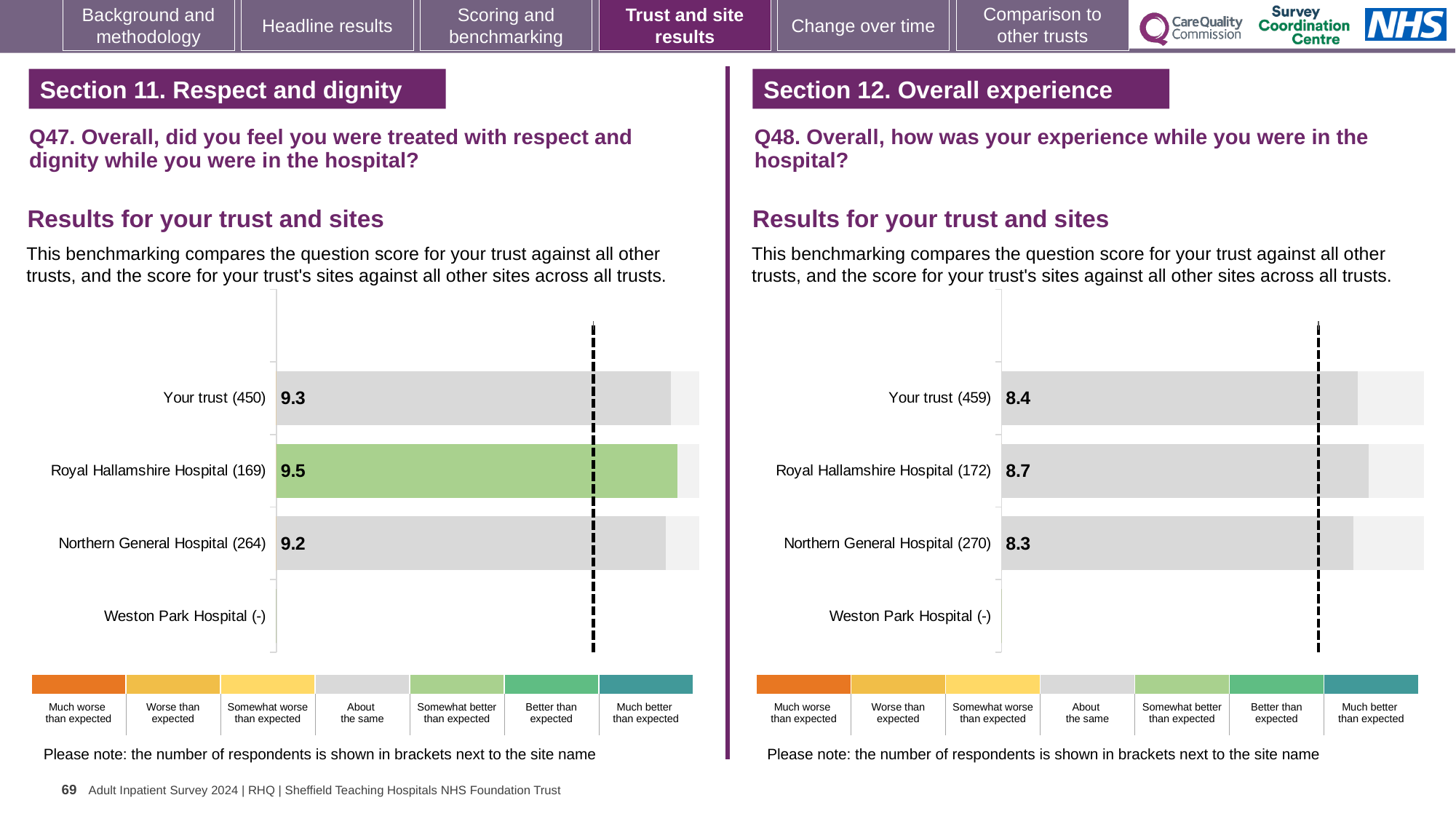
On the Q48 chart (right), what is the difference between the scores for Royal Hallamshire Hospital and Your trust? 0.3 On the Q47 chart (left), which site's bar is coloured green, indicating 'Somewhat better than expected'? Royal Hallamshire Hospital On the Q48 chart (right), what is the score for Northern General Hospital? 8.3 On the Q47 chart (left), what is the difference between the scores for Royal Hallamshire Hospital and Northern General Hospital? 0.3 On the Q47 chart (left), what is the score for Royal Hallamshire Hospital? 9.5 On the Q47 chart (left), what is the score for Your trust? 9.3 On the Q48 chart (right), what is the score for Your trust? 8.4 What kind of chart is used for the Q48 results (right)? Bar chart On the Q48 chart (right), which site with a score shown has the lowest score? Northern General Hospital How many site or trust rows are listed on the Q47 chart (left)? 4 On the Q47 chart (left), which site has the highest score? Royal Hallamshire Hospital On the Q48 chart (right), which has the higher score, Royal Hallamshire Hospital or Northern General Hospital? Royal Hallamshire Hospital